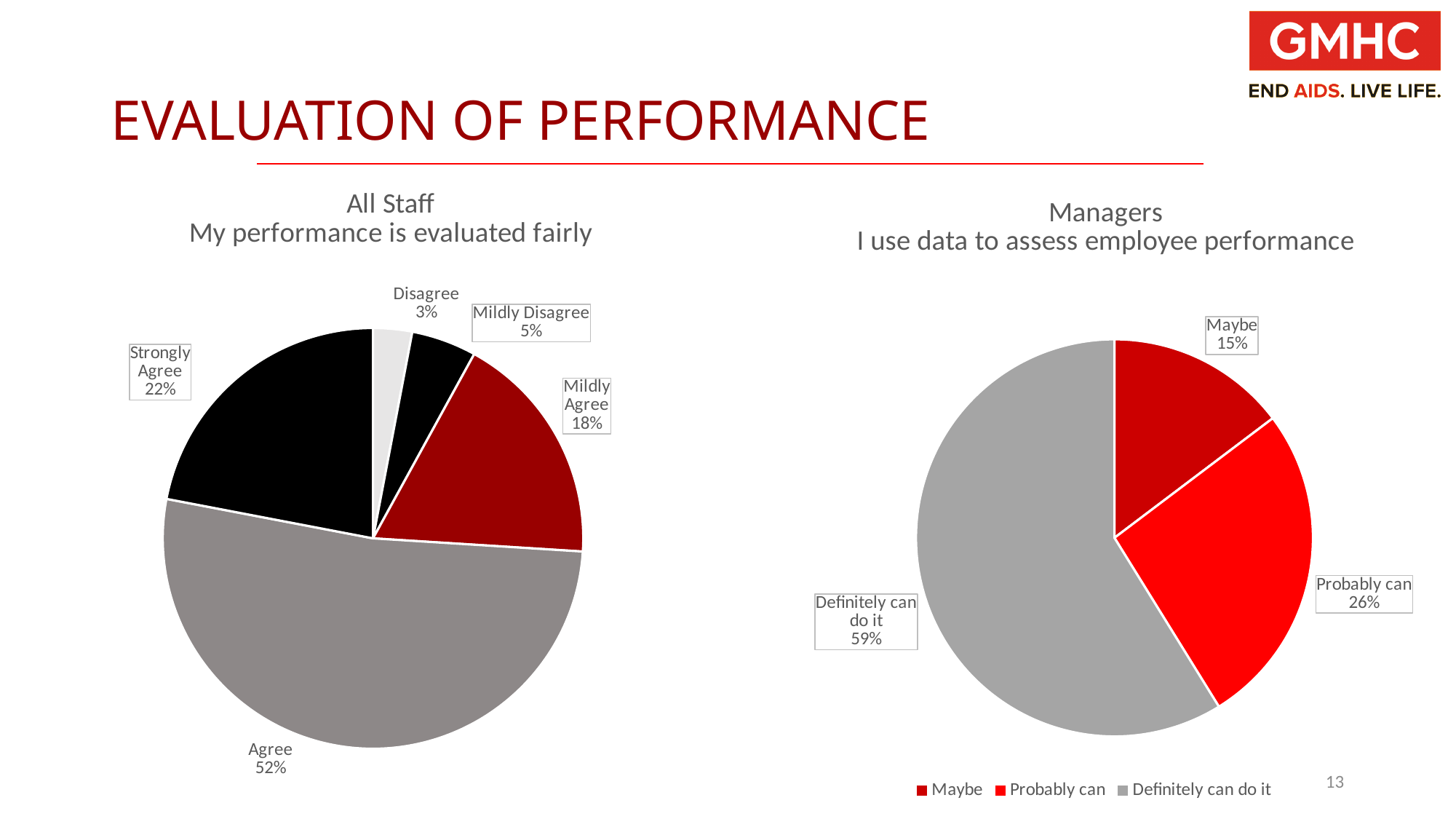
In the 'All Staff – My performance is evaluated fairly' pie chart, what percentage chose Strongly Agree? 22% In the 'All Staff – My performance is evaluated fairly' pie chart, what percentage of respondents chose Agree? 52% In the 'All Staff – My performance is evaluated fairly' pie chart, which response has the smallest share? Disagree In the 'Managers – I use data to assess employee performance' pie chart, what percentage chose Maybe? 15% In the 'Managers – I use data to assess employee performance' pie chart, which is larger: Probably can or Maybe? Probably can In the 'Managers – I use data to assess employee performance' pie chart, what is the difference between Definitely can do it and Probably can? 33% In the 'All Staff – My performance is evaluated fairly' pie chart, which response has the largest share? Agree In the 'Managers – I use data to assess employee performance' pie chart, what percentage chose Definitely can do it? 59% In the 'All Staff – My performance is evaluated fairly' pie chart, what is the difference between the Mildly Agree and Mildly Disagree shares? 13% How many entries does the legend of the 'Managers – I use data to assess employee performance' chart list? 3 What type of chart is used for the 'All Staff – My performance is evaluated fairly' data? Pie chart In the 'All Staff – My performance is evaluated fairly' pie chart, how many response categories are shown? 5